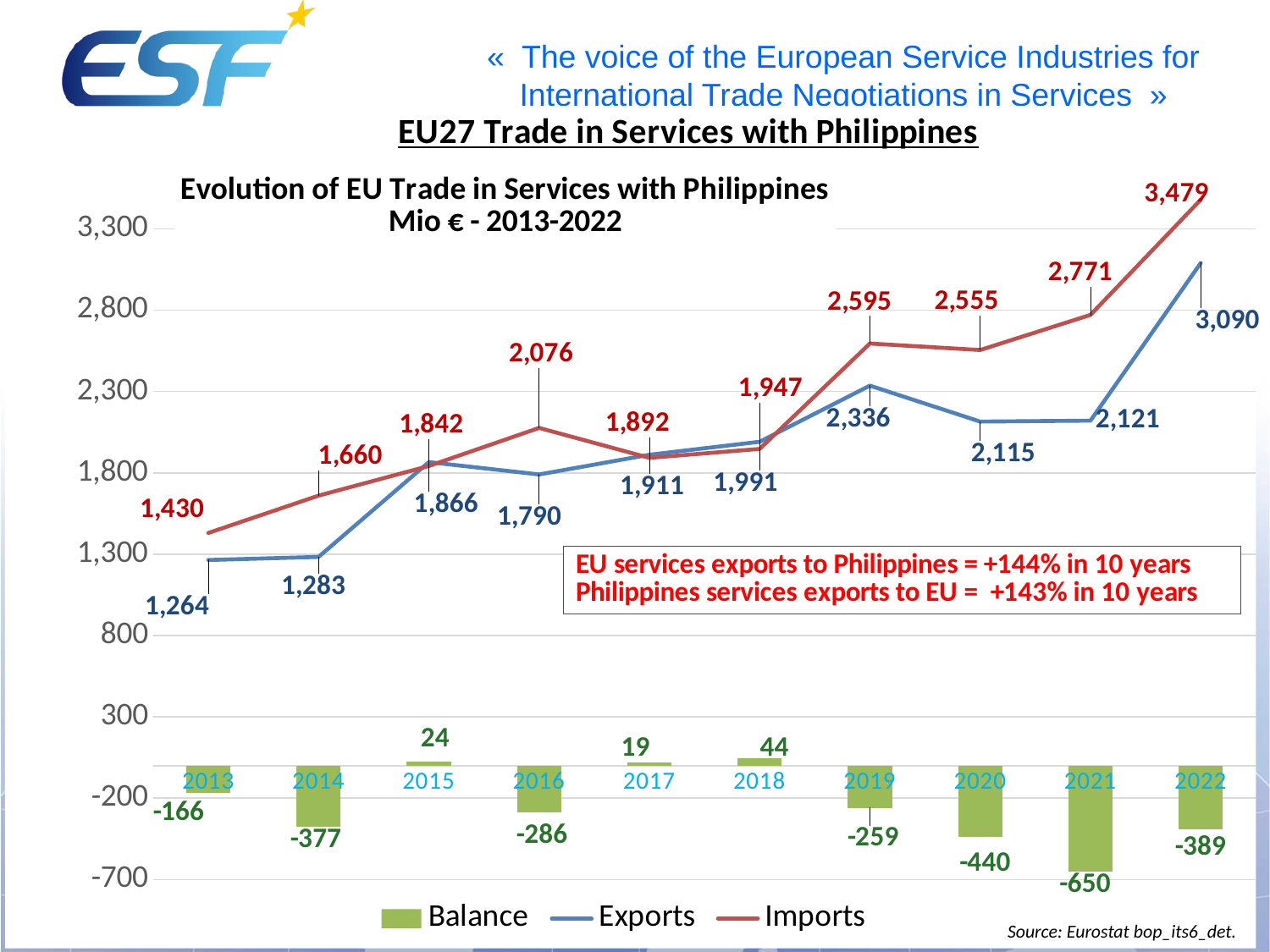
Is the value for Imports in 2013 greater or less than 1,300? greater In which year are Imports highest? 2022 How many series does the legend list? 3 What is the difference between Imports and Exports in 2022? 389 What is the value of Exports in 2022? 3,090 What is the value of Imports in 2016? 2,076 In which year is the Balance lowest? 2021 In 2015, which is larger, Exports or Imports? Exports How many years are shown on the x axis? 10 Do Imports rise or fall from 2013 to 2016? rise In which year are Exports lowest? 2013 What is the Balance value for 2021? -650